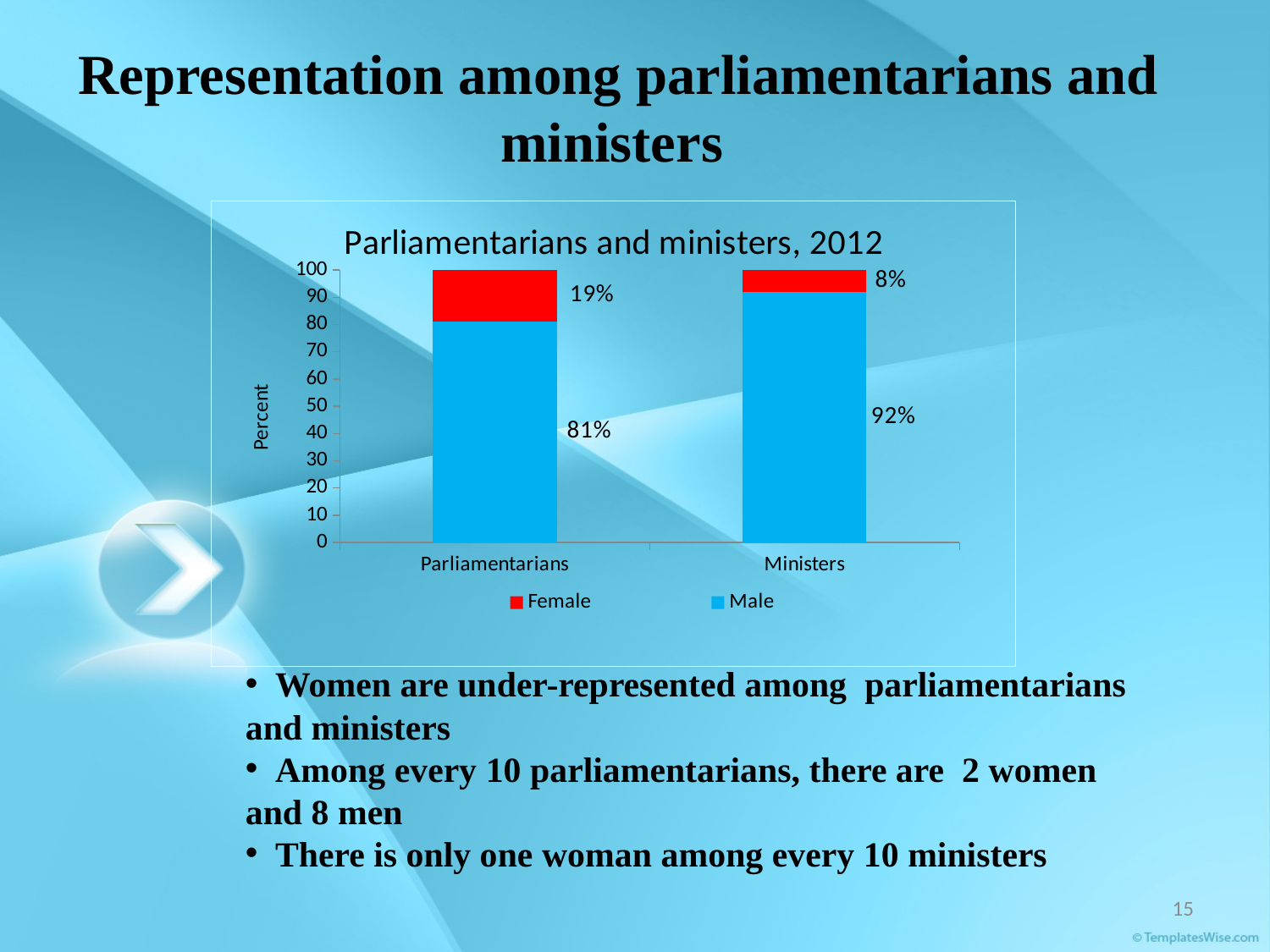
What is the Male value for Ministers? 92% How many series does the legend list? 2 What is the Female value for Parliamentarians? 19% Which category has the higher Female share, Parliamentarians or Ministers? Parliamentarians What kind of chart is shown? Stacked bar chart What is the total of the stacked bar for Parliamentarians? 100% What is the difference between the Female values for Parliamentarians and Ministers? 11% How many categories are shown on the x axis? 2 What is the title of the chart? Parliamentarians and ministers, 2012 What is the Female value for Ministers? 8% Which category has the lowest Male value? Parliamentarians What is the Male value for Parliamentarians? 81%